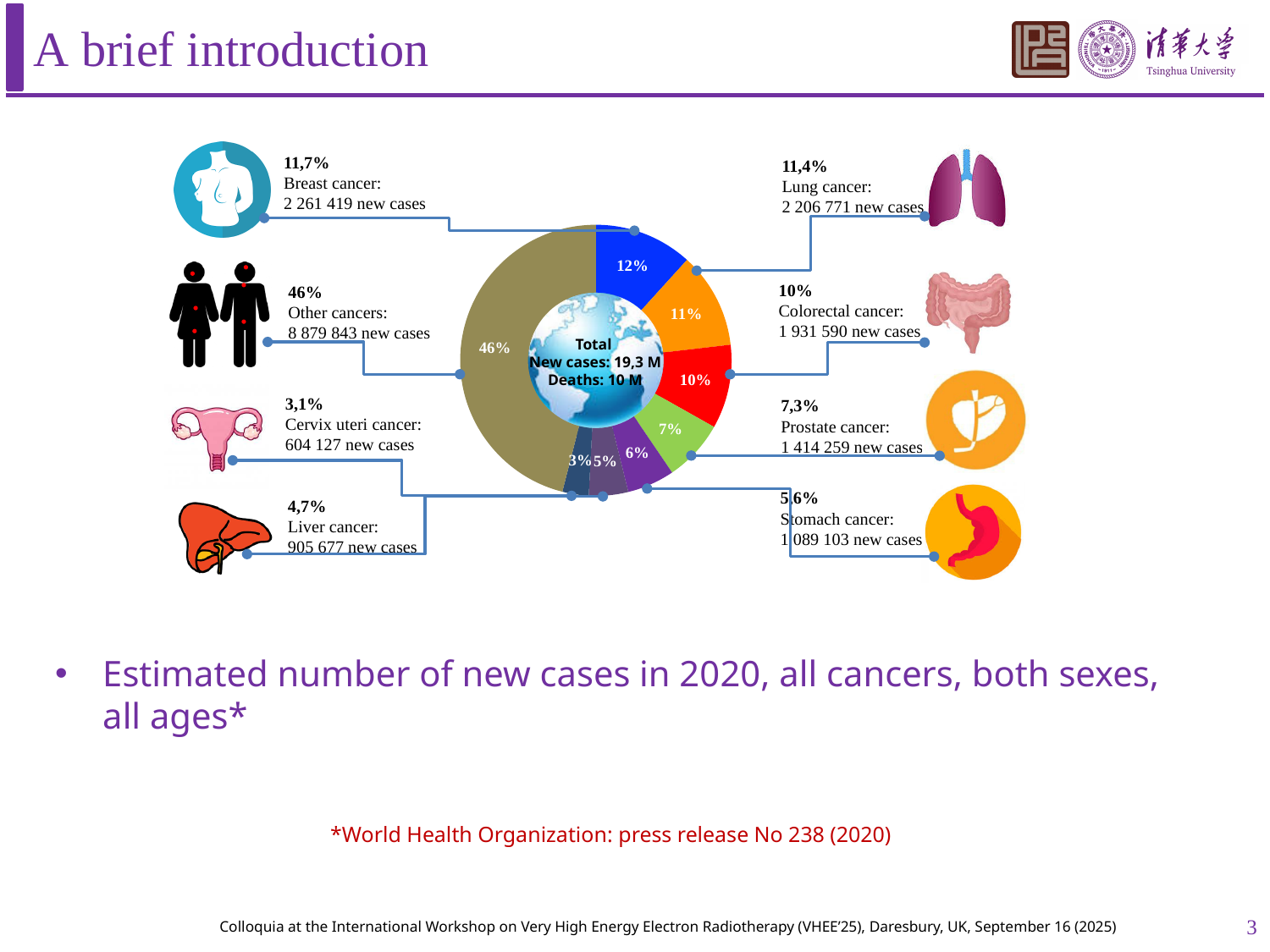
What is the difference in new cases between breast cancer and lung cancer? 54 648 What is the total number of new cases shown in the centre of the chart? 19,3 M Which named cancer type has the smallest slice of the pie chart? Cervix uteri cancer Which category has the largest slice of the pie chart? Other cancers What share of the pie does stomach cancer take according to its callout? 5,6% What kind of chart is shown on the slide? Doughnut chart What number of deaths is shown in the centre of the chart? 10 M Which has more new cases, colorectal cancer or prostate cancer? Colorectal cancer How many cancer categories (slices) does the pie chart show? 8 What percentage is given for prostate cancer in its callout? 7,3% How many new cases of breast cancer are shown on the slide? 2 261 419 How many new cases of lung cancer are shown on the slide? 2 206 771